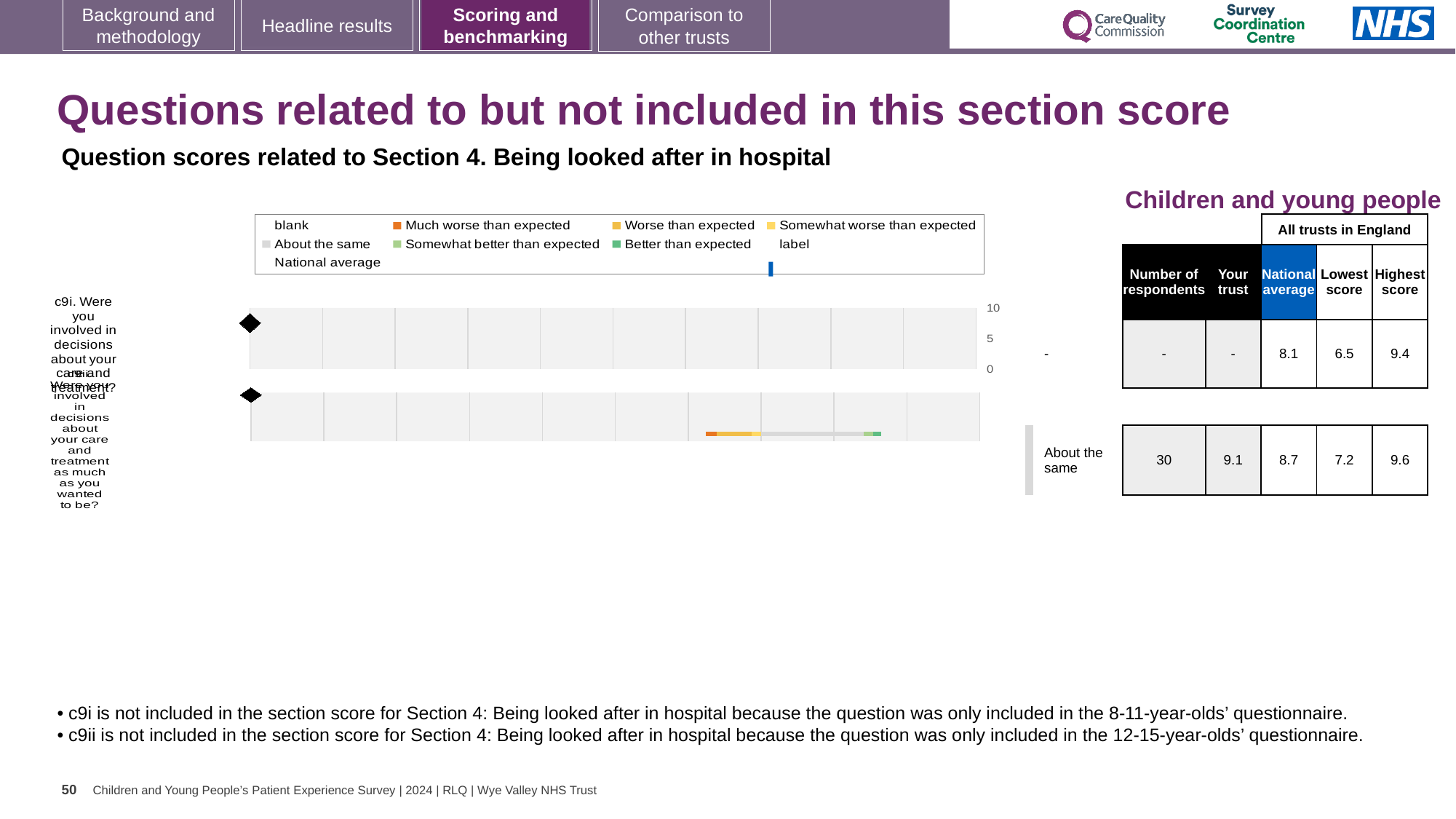
Which is larger for question c9ii: the 'Your trust' score or the national average? Your trust What is the difference between the highest and lowest scores across all trusts for question c9i? 2.9 What is the 'Your trust' score for question c9ii? 9.1 What is the national average score for question c9ii (About the same)? 8.7 What is the highest value shown on the chart's axis? 10 How many questions (rows) are plotted in the chart? 2 What is the lowest score across all trusts in England for question c9i? 6.5 What kind of chart is shown on the slide? bar chart What is the national average score for question c9i? 8.1 How many respondents are listed for question c9ii? 30 What is the highest score across all trusts in England for question c9ii? 9.6 What is the lowest score across all trusts in England for question c9ii? 7.2